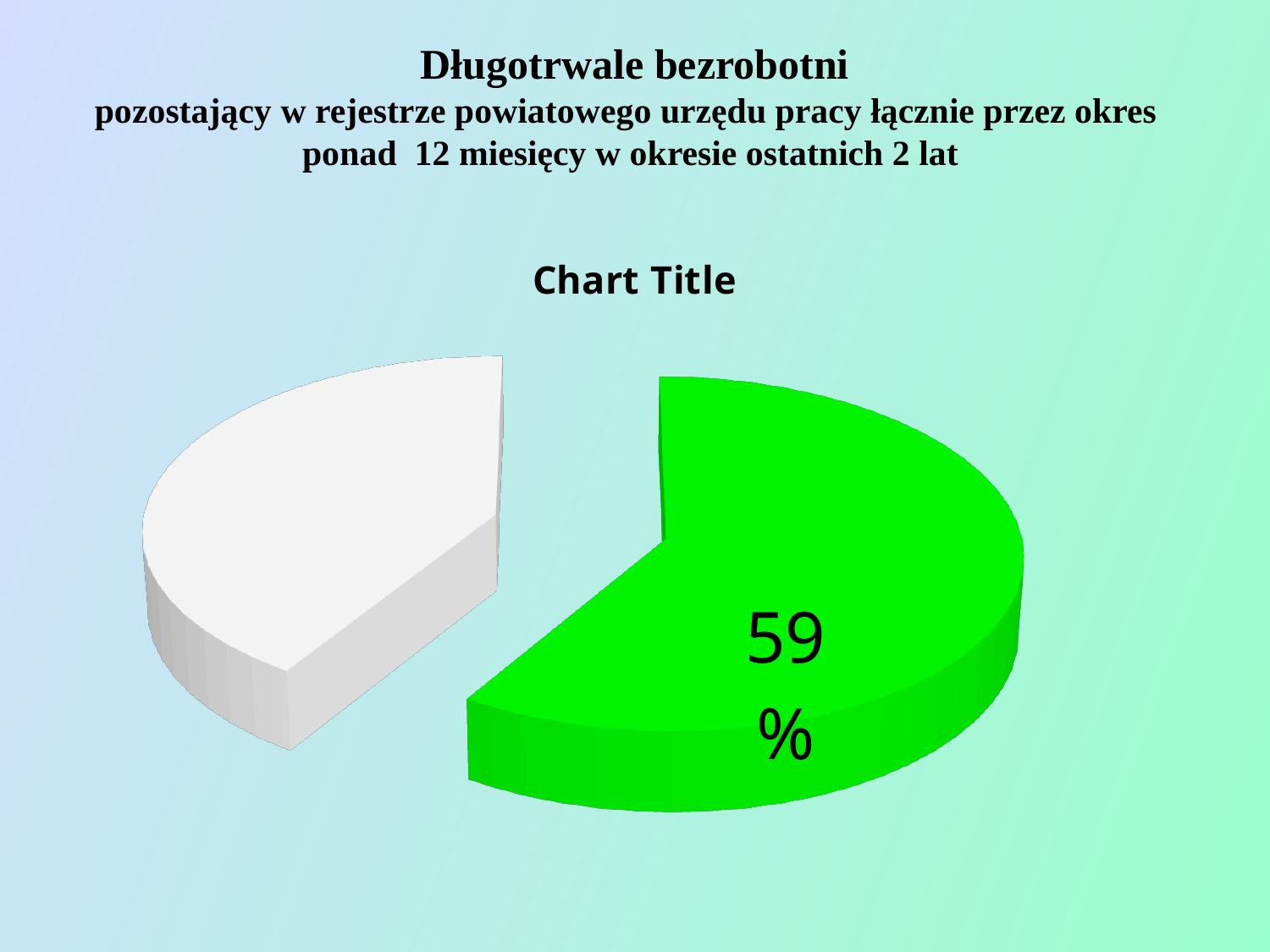
Which slice of the pie chart is the largest? the green slice What kind of chart is shown on the slide? pie chart Is the share of the green slice greater or less than 50%? greater What title is printed directly above the pie chart? Chart Title What colour is the slice that carries the data label on the pie chart? green How many slices does the pie chart have? 2 Which slice of the pie chart is the smallest? the white slice What percentage is printed on the green slice of the pie chart? 59% Which slice of the pie chart is larger, the green one or the white one? the green one